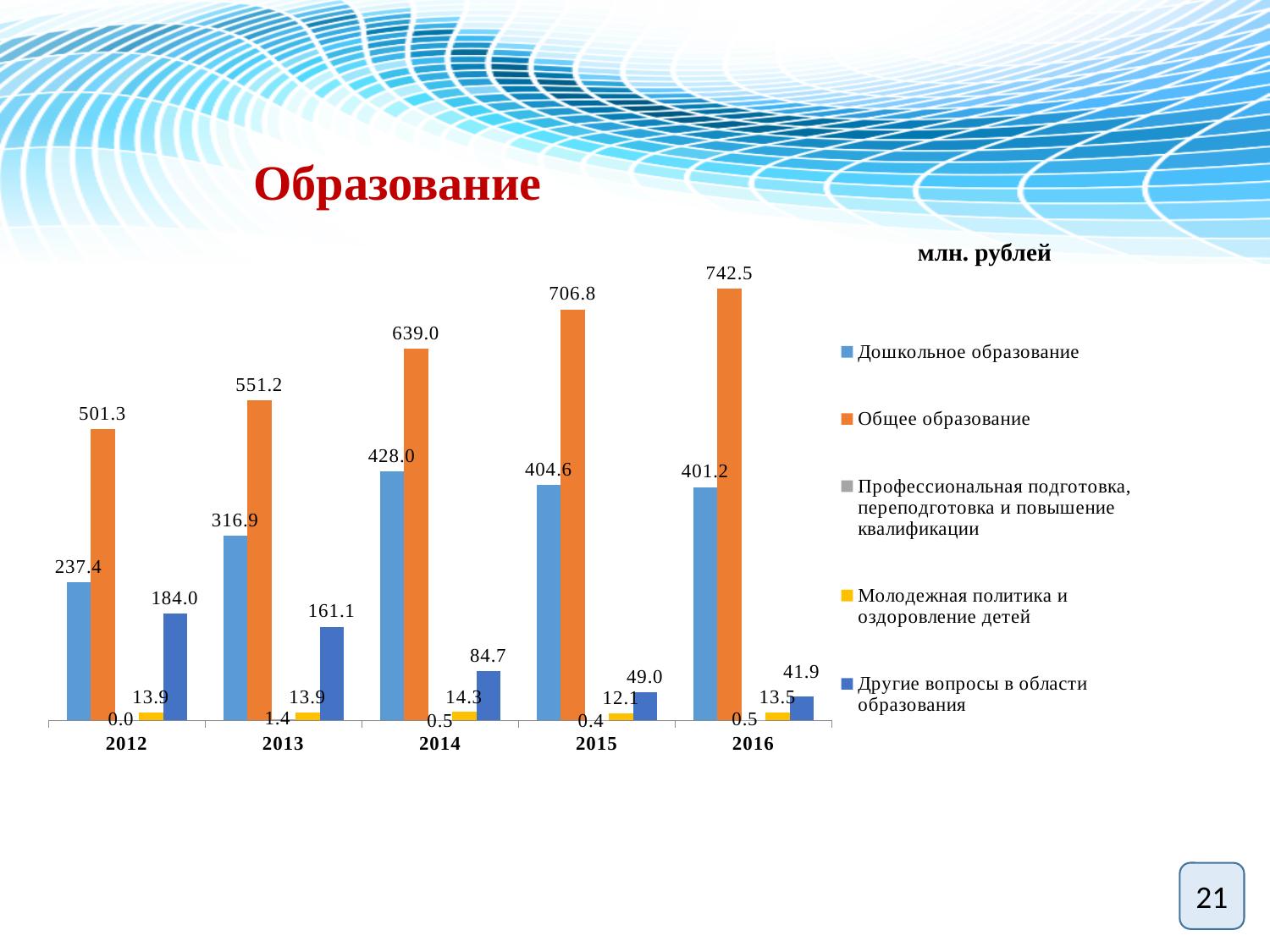
What is the value for Молодежная политика и оздоровление детей in 2015? 12.1 What is the value for Общее образование in 2016? 742.5 What kind of chart is shown on the slide? bar chart In which year is the value for Другие вопросы в области образования the lowest? 2016 How many years are shown on the x axis? 5 How many series does the legend list? 5 Which is larger in 2015: Дошкольное образование or Общее образование? Общее образование In which year is the value for Общее образование the highest? 2016 What is the value for Другие вопросы в области образования in 2012? 184.0 What is the value for Дошкольное образование in 2014? 428.0 Do the values for Общее образование rise or fall from 2012 to 2016? rise What is the difference between the Общее образование values for 2016 and 2015? 35.7